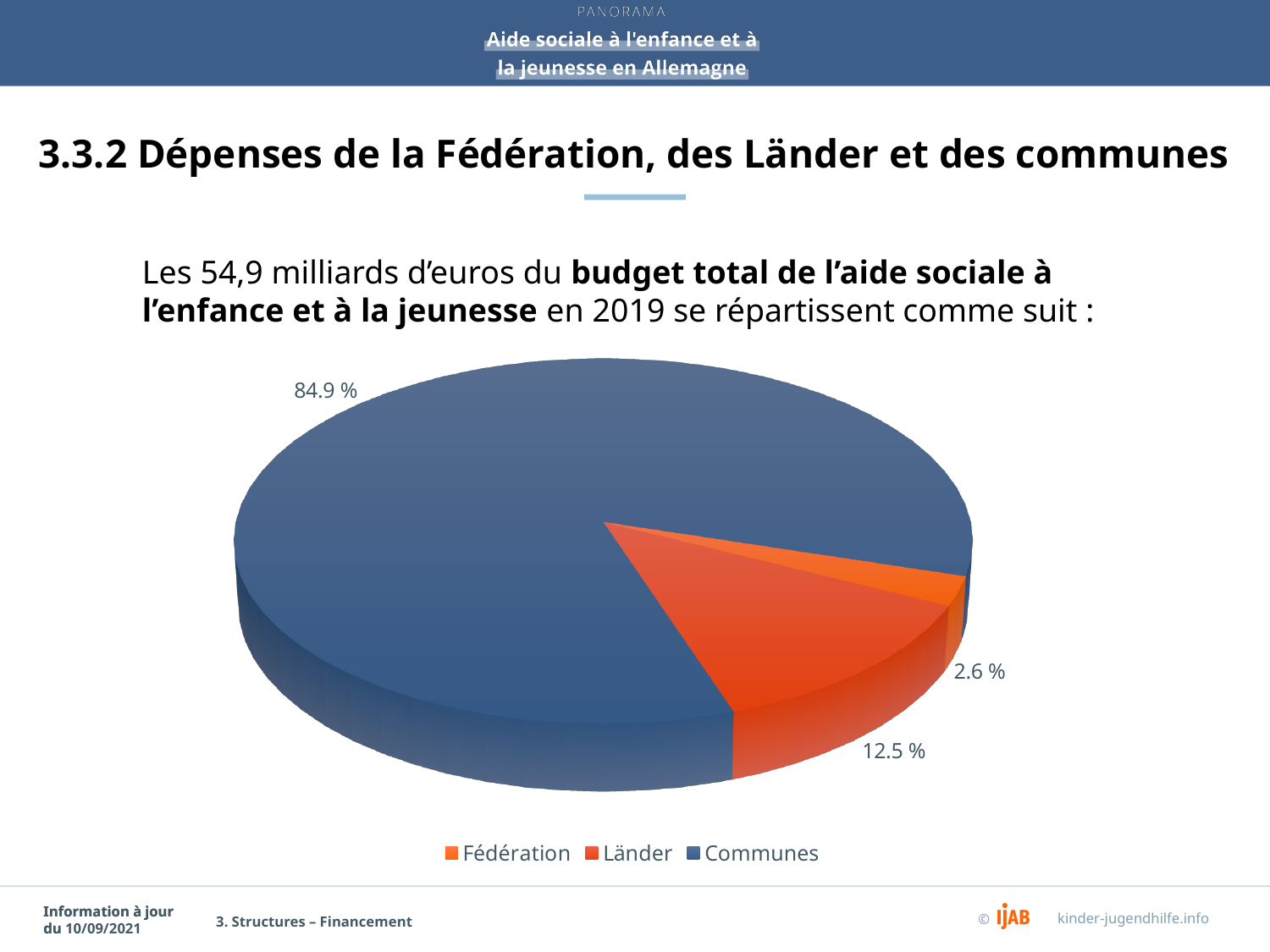
How many slices does the pie chart have? 3 Which category has the largest share of the pie? Communes Which has the larger share, Länder or Fédération? Länder What kind of chart is shown on the slide? pie chart How many entries does the legend of the pie chart list? 3 What share of the budget goes to the Länder? 12.5 % What colour is the Communes slice in the pie chart? blue What share of the budget goes to the Fédération? 2.6 % Which category has the smallest share of the pie? Fédération What is the difference in percentage points between the Communes share and the Länder share? 72.4 % What share of the budget goes to Communes? 84.9 % What is the difference in percentage points between the Länder share and the Fédération share? 9.9 %